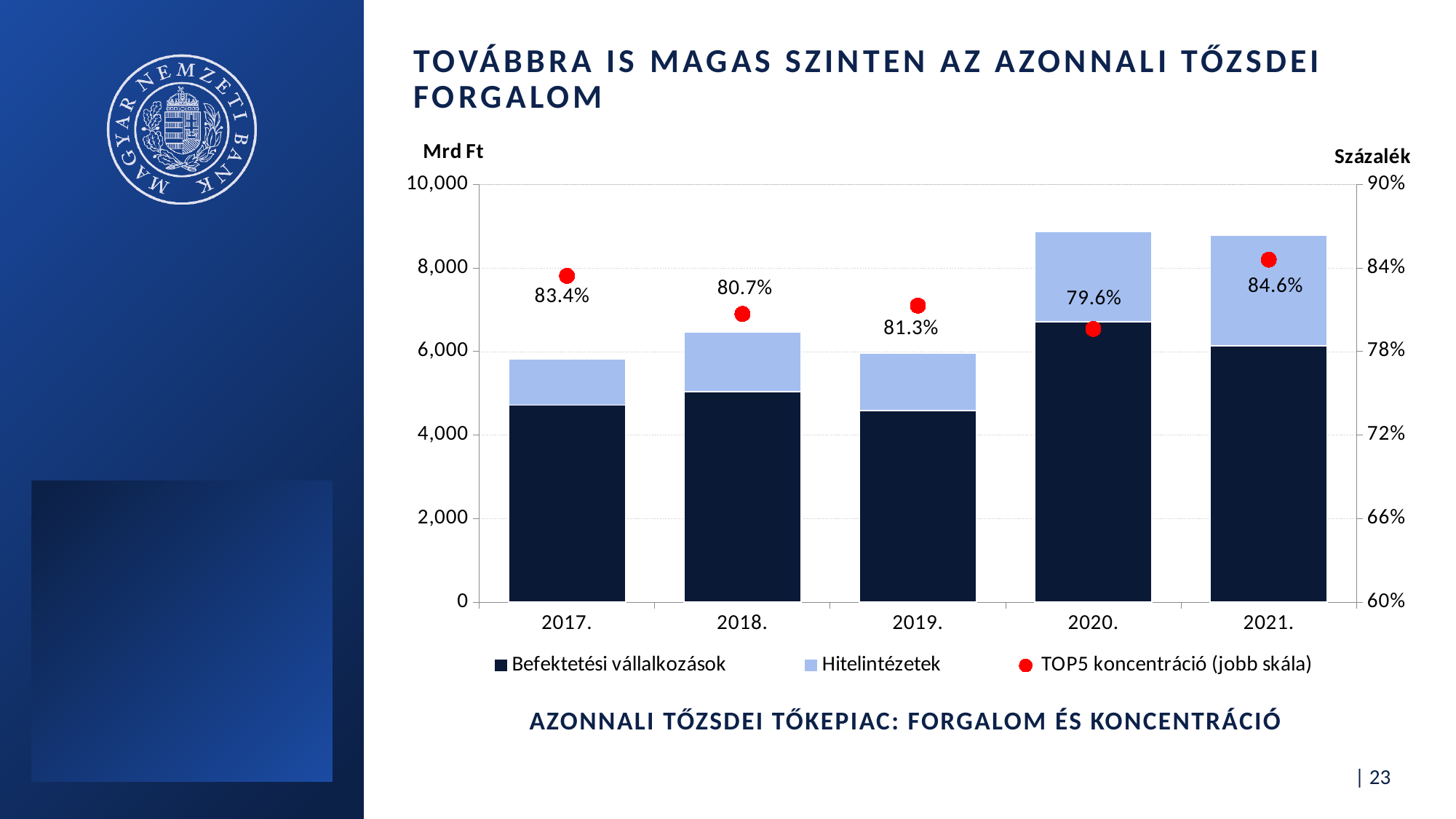
What kind of chart is shown on the slide? Stacked bar chart with a dot series on a secondary axis In which year is the TOP5 koncentráció highest? 2021. What is the difference between the TOP5 koncentráció values for 2021 and 2020? 5.0 percentage points Is the total height of the stacked bar for 2017 greater or less than 6,000 Mrd Ft? less Which year has the larger TOP5 koncentráció value, 2018 or 2019? 2019. How many series does the legend list? 3 In which year is the TOP5 koncentráció lowest? 2020. What is the TOP5 koncentráció value for 2017? 83.4% What is the TOP5 koncentráció value for 2020? 79.6% What is the unit label shown above the right-hand axis? Százalék Is the total height of the stacked bar for 2020 greater or less than 8,000 Mrd Ft? greater How many years are shown on the x axis? 5